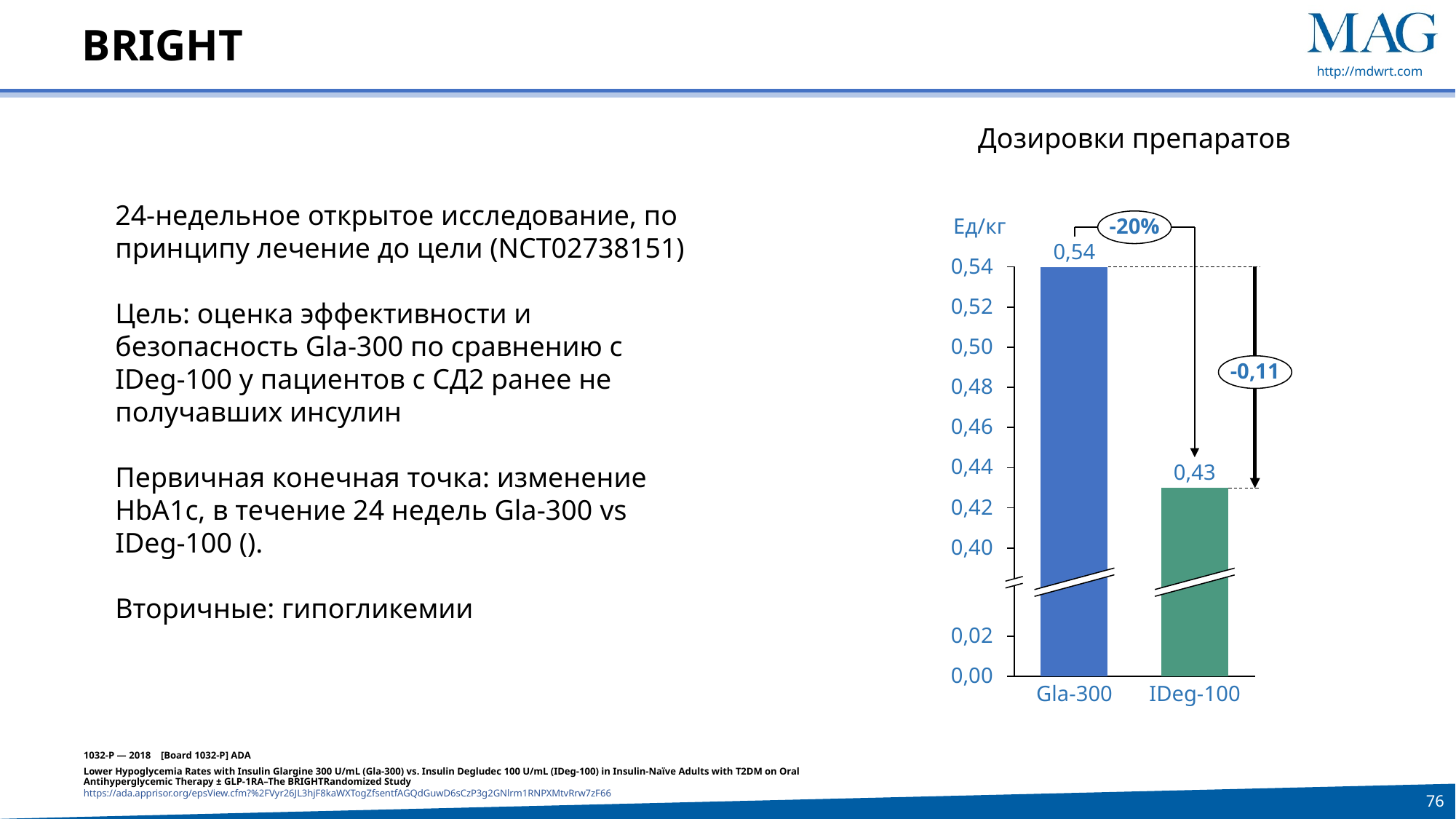
Which category has the higher value, Gla-300 or IDeg-100? Gla-300 How many categories are shown in the chart? 2 What is the title of the chart? Дозировки препаратов What kind of chart is shown on the slide? Bar chart What unit is shown on the y axis of the chart? Ед/кг What is the value for Gla-300 in the chart? 0,54 What is the value for IDeg-100 in the chart? 0,43 Which category has the lowest value in the chart? IDeg-100 Which category has the highest value in the chart? Gla-300 Is the value for Gla-300 greater or less than 0,50? greater What is the difference between the Gla-300 and IDeg-100 values? 0,11 Is the value for IDeg-100 greater or less than 0,50? less